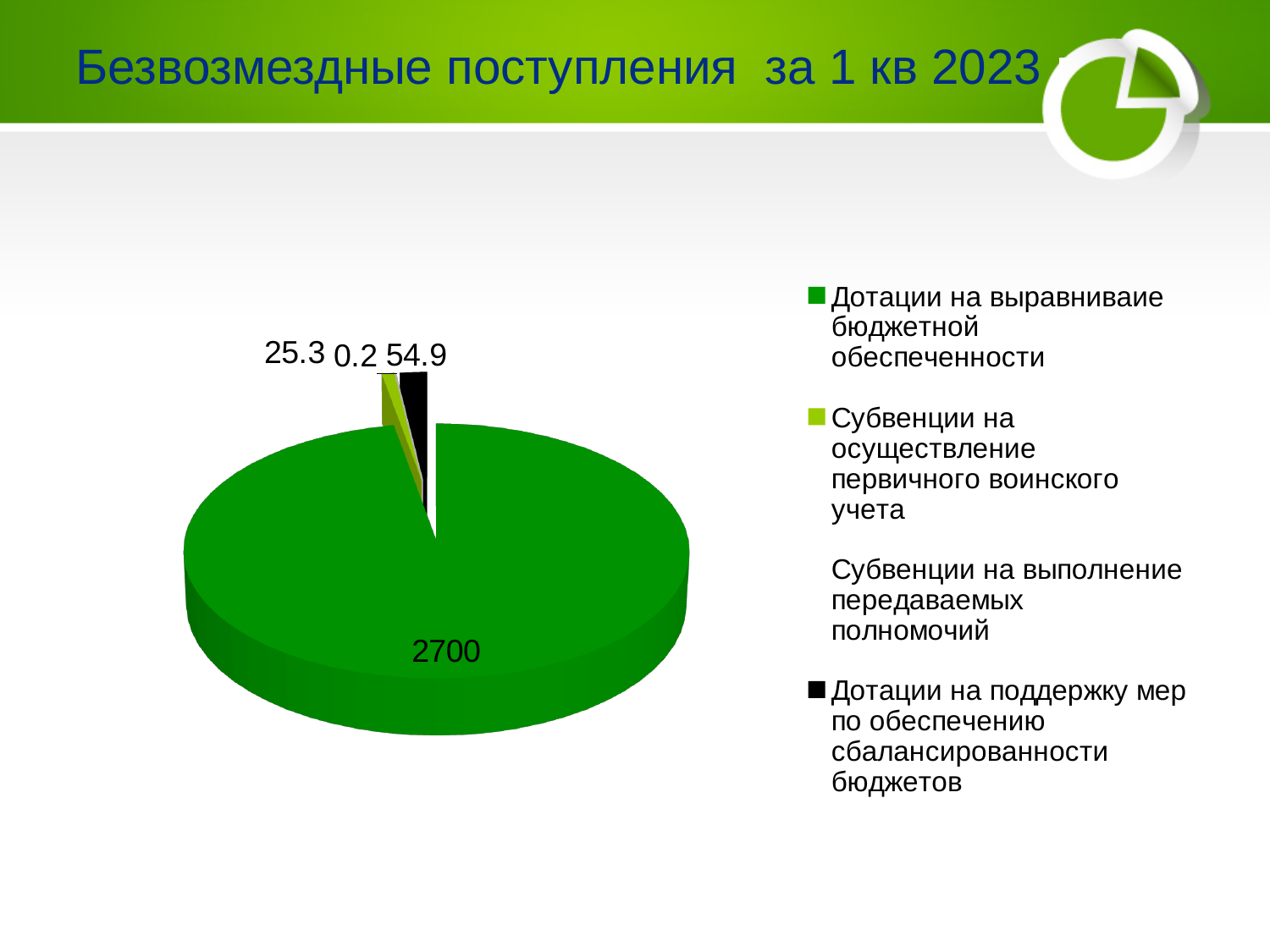
What is the title of the slide containing the chart? Безвозмездные поступления за 1 кв 2023 How many categories does the pie chart have? 4 What is the value for Дотации на поддержку мер по обеспечению сбалансированности бюджетов? 54.9 What is the total of all the values shown on the pie chart? 2780.4 What is the value for Субвенции на осуществление первичного воинского учета? 25.3 Which category has the largest slice of the pie? Дотации на выравниваие бюджетной обеспеченности What is the value for Дотации на выравниваие бюджетной обеспеченности? 2700 What is the value for Субвенции на выполнение передаваемых полномочий? 0.2 Which is larger: the value for Субвенции на осуществление первичного воинского учета or the value for Дотации на поддержку мер по обеспечению сбалансированности бюджетов? Дотации на поддержку мер по обеспечению сбалансированности бюджетов What kind of chart is shown on the slide? Pie chart Which category has the smallest slice of the pie? Субвенции на выполнение передаваемых полномочий What is the difference between the value for Дотации на поддержку мер по обеспечению сбалансированности бюджетов and the value for Субвенции на осуществление первичного воинского учета? 29.6